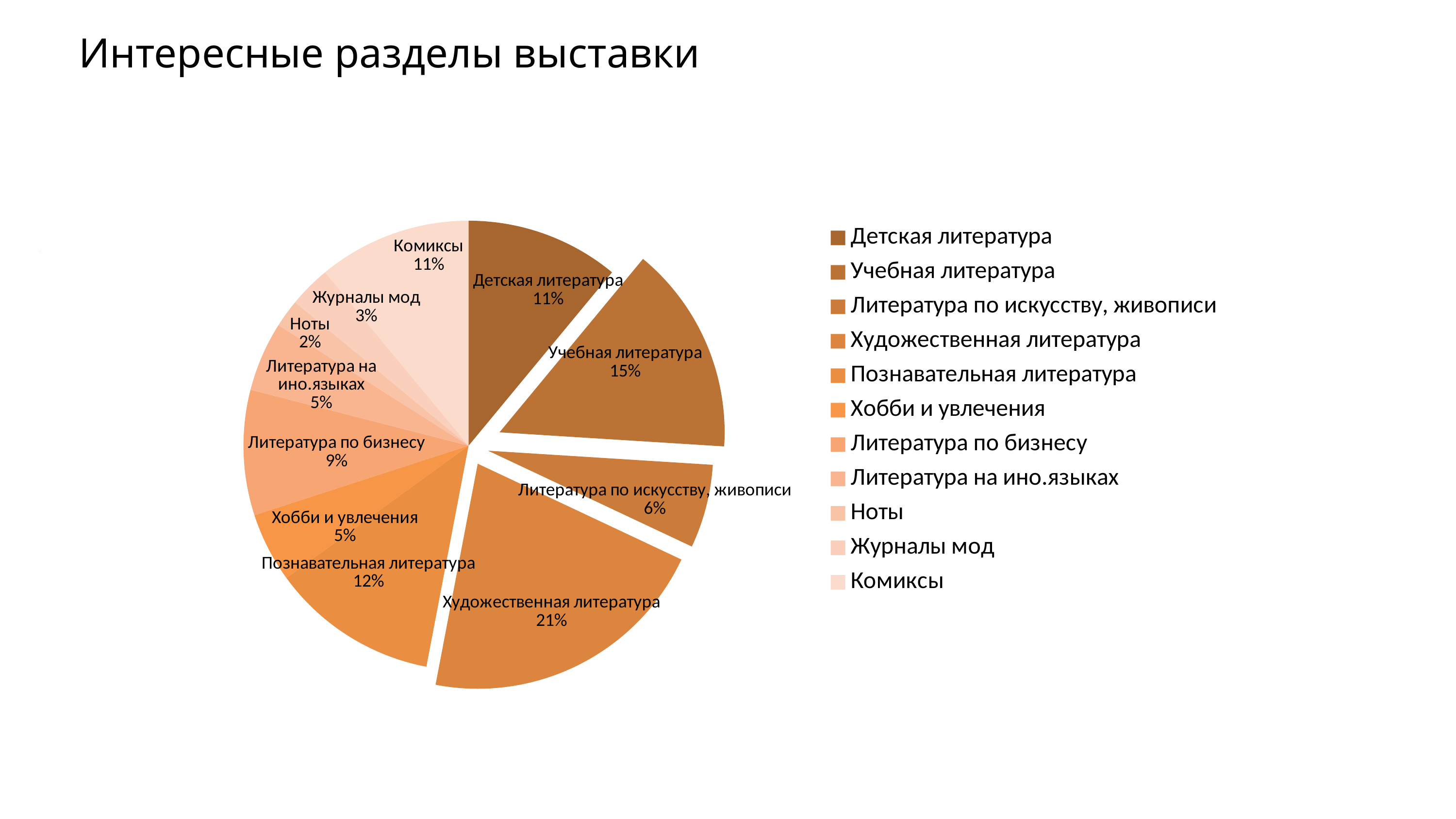
What share does Художественная литература have? 21% Which category has the smallest share? Ноты What is the difference between the shares of Познавательная литература and Литература по бизнесу? 3% Which category has the largest share? Художественная литература What share does Ноты have? 2% What share does Литература по искусству, живописи have? 6% What kind of chart is shown on the slide? pie chart Which is larger, Комиксы or Журналы мод? Комиксы What is the title of the slide? Интересные разделы выставки What share does Учебная литература have? 15% How many categories does the pie chart have? 11 What is the combined share of Детская литература and Учебная литература? 26%